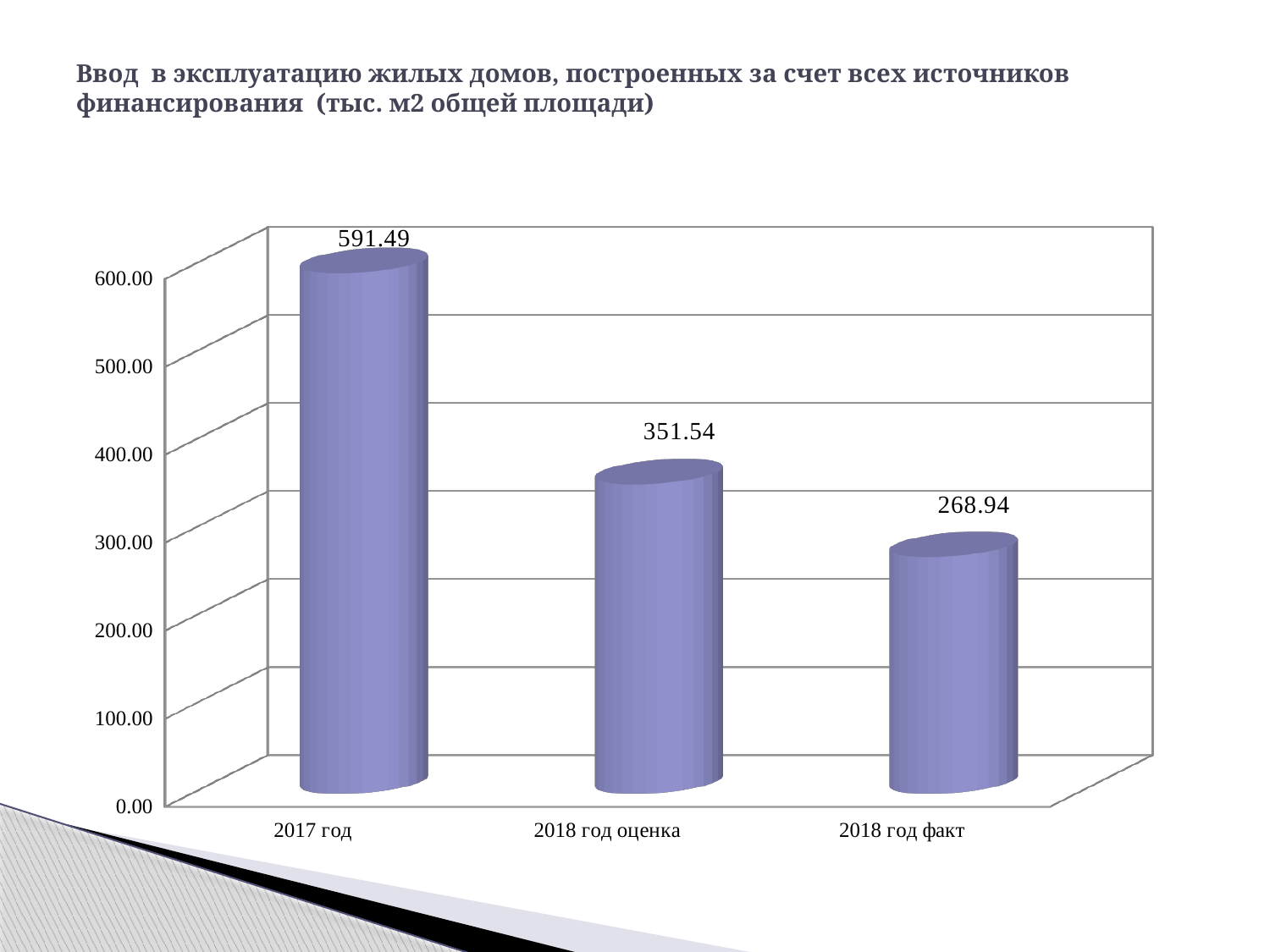
Which is larger, the value for 2018 год оценка or 2018 год факт? 2018 год оценка What is the value for 2018 год факт? 268.94 Do the values rise or fall from left to right along the x axis? fall Which category has the lowest value? 2018 год факт What kind of chart is shown on the slide? bar chart What is the difference between the values for 2018 год оценка and 2018 год факт? 82.60 What is the value for 2018 год оценка? 351.54 How many categories are shown on the x axis? 3 What is the value for 2017 год? 591.49 Which category has the highest value? 2017 год Is the value for 2018 год факт greater or less than 300.00? less What is the difference between the values for 2017 год and 2018 год факт? 322.55